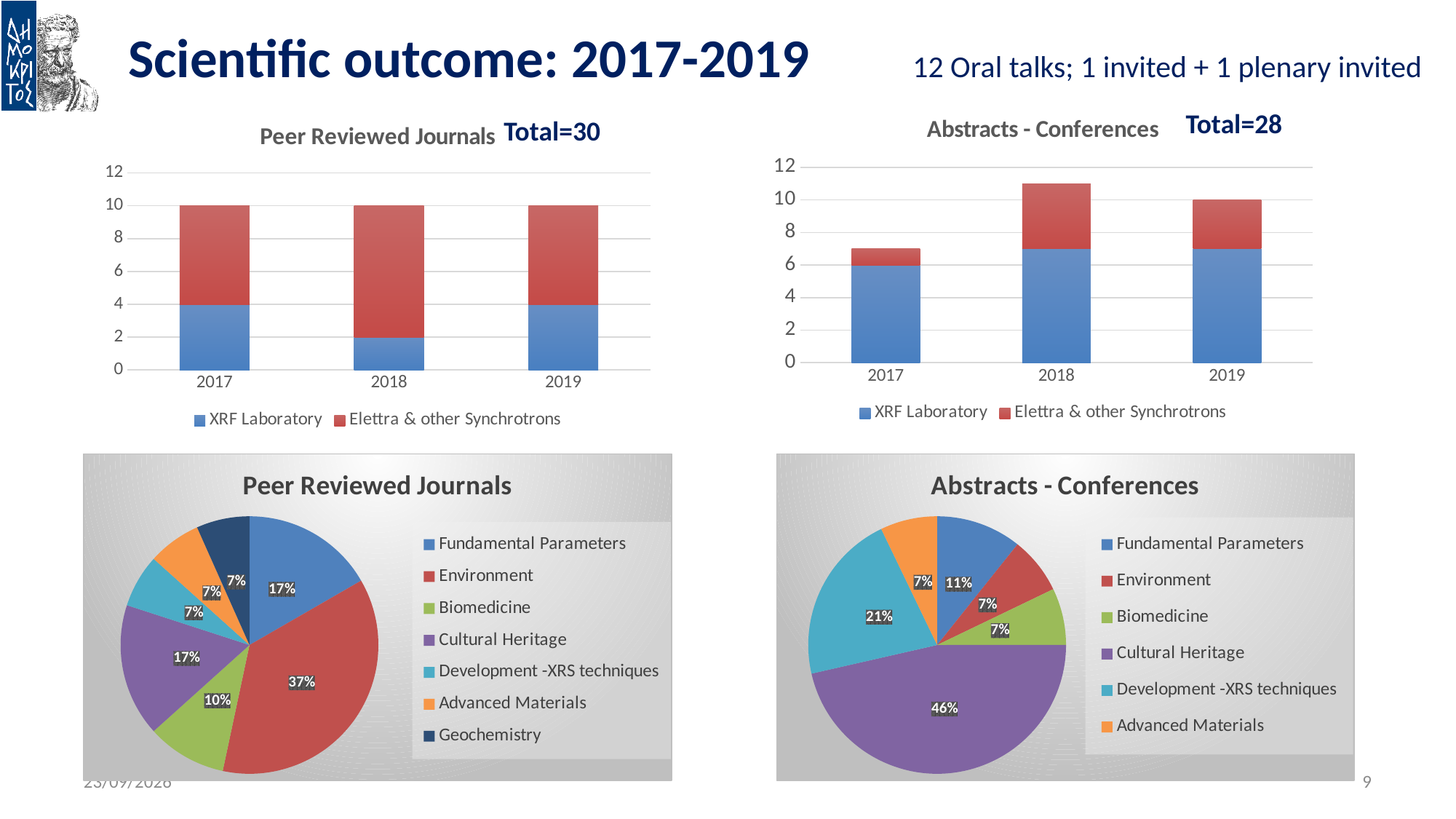
In the Abstracts - Conferences pie chart, which category has the largest share? Cultural Heritage What kind of chart is the Peer Reviewed Journals chart at the top left of the slide? Stacked bar chart In the Abstracts - Conferences pie chart, what share does Cultural Heritage have? 46% In the Abstracts - Conferences bar chart at the top right, is the total for 2018 greater or less than 10? greater How many categories does the legend of the Peer Reviewed Journals pie chart list? 7 In the Peer Reviewed Journals pie chart, what share does Environment have? 37% How many categories does the legend of the Abstracts - Conferences pie chart list? 6 In the Peer Reviewed Journals bar chart at the top left, what is the total of the stacked bar for 2017? 10 How many series does the legend of the Abstracts - Conferences bar chart list? 2 In the Peer Reviewed Journals pie chart, what is the difference between the Environment share and the Biomedicine share? 27% In the Abstracts - Conferences pie chart, which is larger: Development -XRS techniques or Fundamental Parameters? Development -XRS techniques In the Peer Reviewed Journals bar chart at the top left, what is the value for XRF Laboratory in 2018? 2